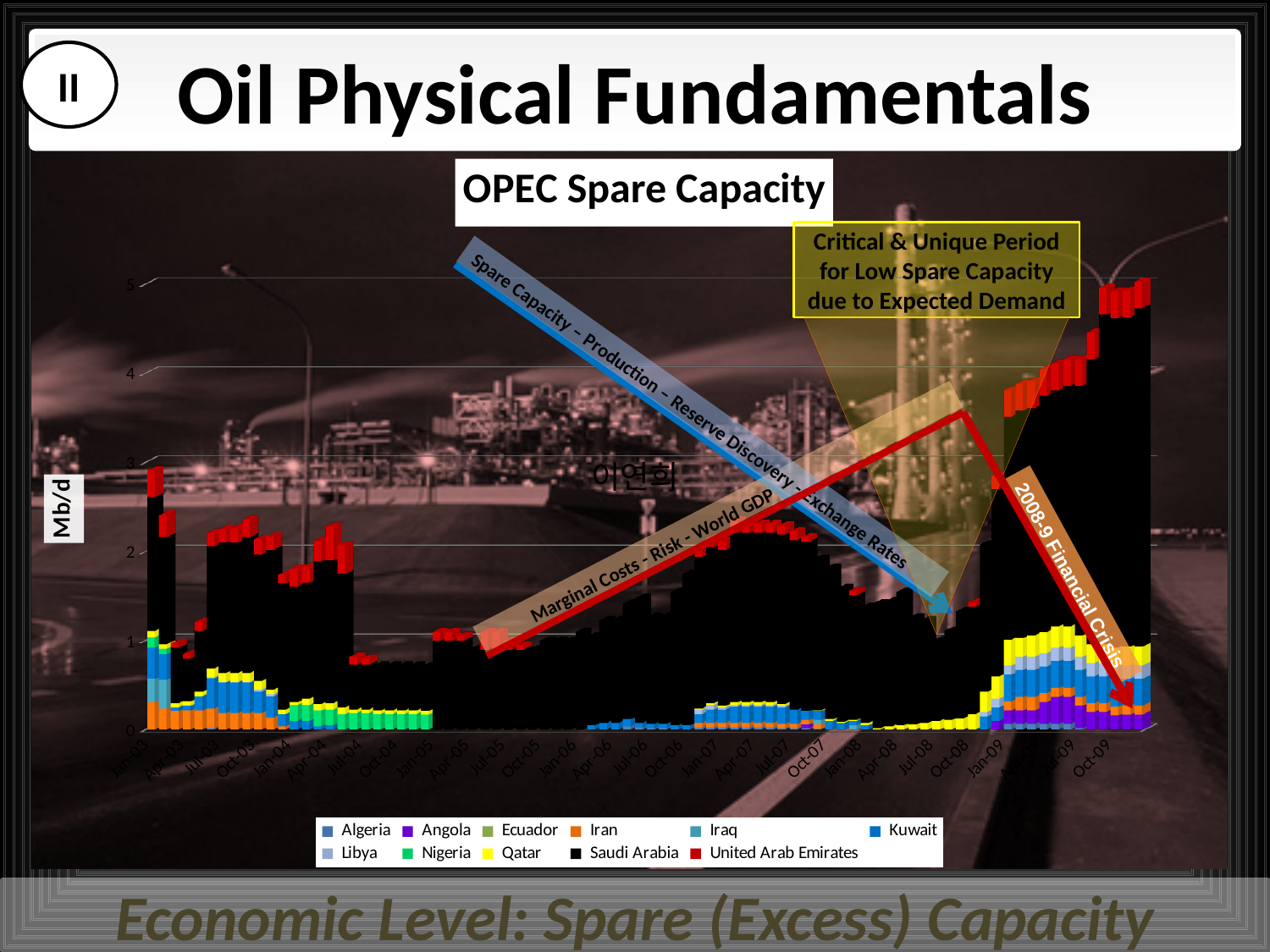
Is the total spare capacity for Jan-03 greater or less than 2 Mb/d? greater Which has the larger total spare capacity, Jan-03 or Jul-04? Jan-03 Is the total spare capacity for Jan-09 greater or less than 3 Mb/d? greater Is the total spare capacity for Jan-08 greater or less than 2 Mb/d? less What is the label on the vertical axis of the chart? Mb/d How many series does the chart legend list? 11 Which has the larger total spare capacity, Jan-03 or Oct-09? Oct-09 What is the title of the chart? OPEC Spare Capacity Does total spare capacity rise or fall between Jul-08 and Oct-09? Rise What type of chart is shown on the slide? Stacked bar chart